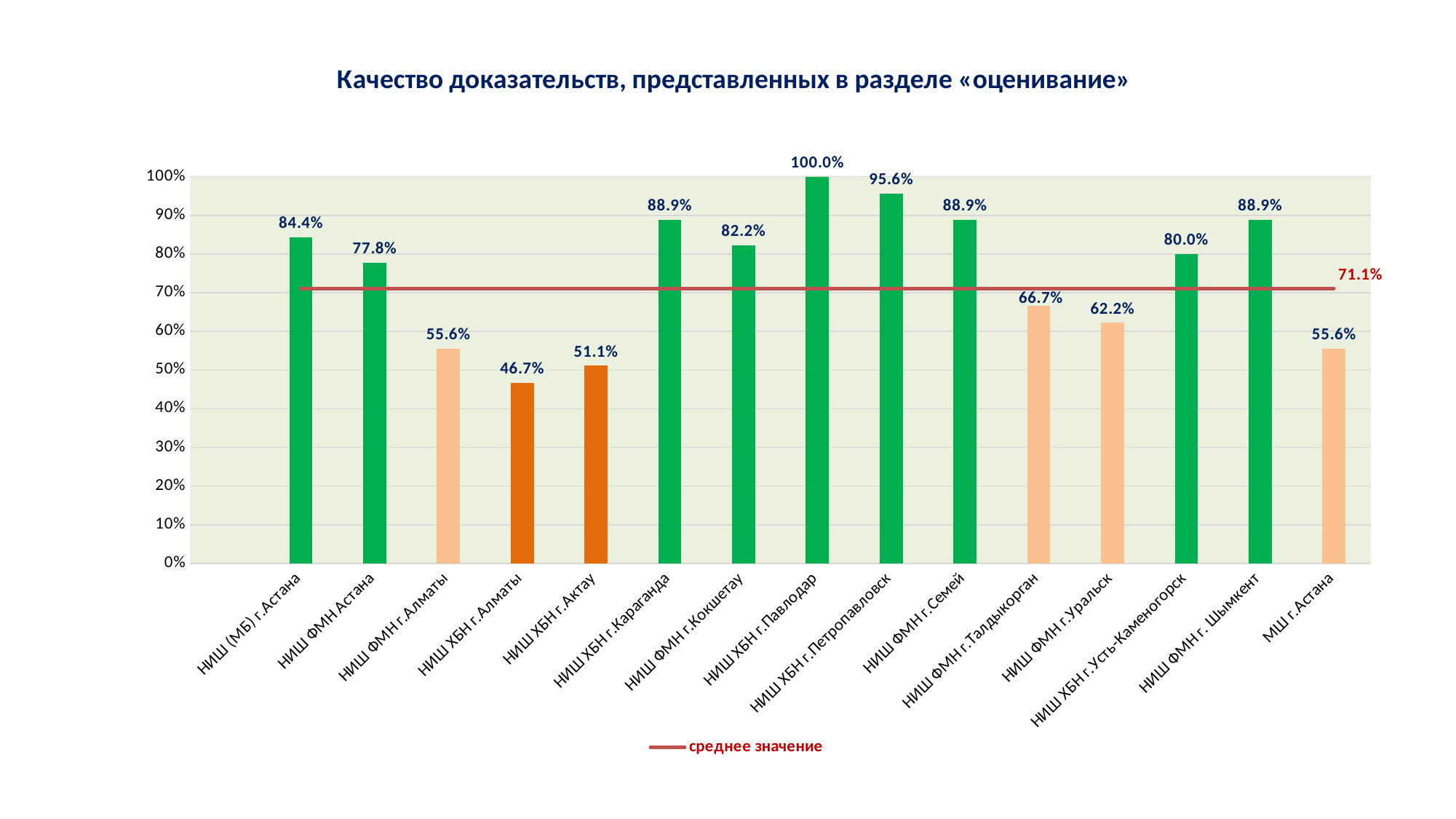
What value is marked by the red horizontal line labelled 'среднее значение'? 71.1% Which is larger, the value for НИШ (МБ) г.Астана or the value for НИШ ФМН Астана? НИШ (МБ) г.Астана What kind of chart is shown on the slide? Combination bar and line chart (bars with a horizontal average line) Which category has the highest value? НИШ ХБН г.Павлодар How many entries does the legend list? 1 What is the value for НИШ ФМН г.Уральск? 62.2% How many categories are shown on the x axis? 15 Which category has the lowest value? НИШ ХБН г.Алматы What is the value for НИШ ХБН г.Усть-Каменогорск? 80.0% What is the title of the chart? Качество доказательств, представленных в разделе «оценивание» What is the value for НИШ ХБН г.Павлодар? 100.0% What is the difference between the values for НИШ ХБН г.Петропавловск and НИШ ФМН г.Кокшетау? 13.4%